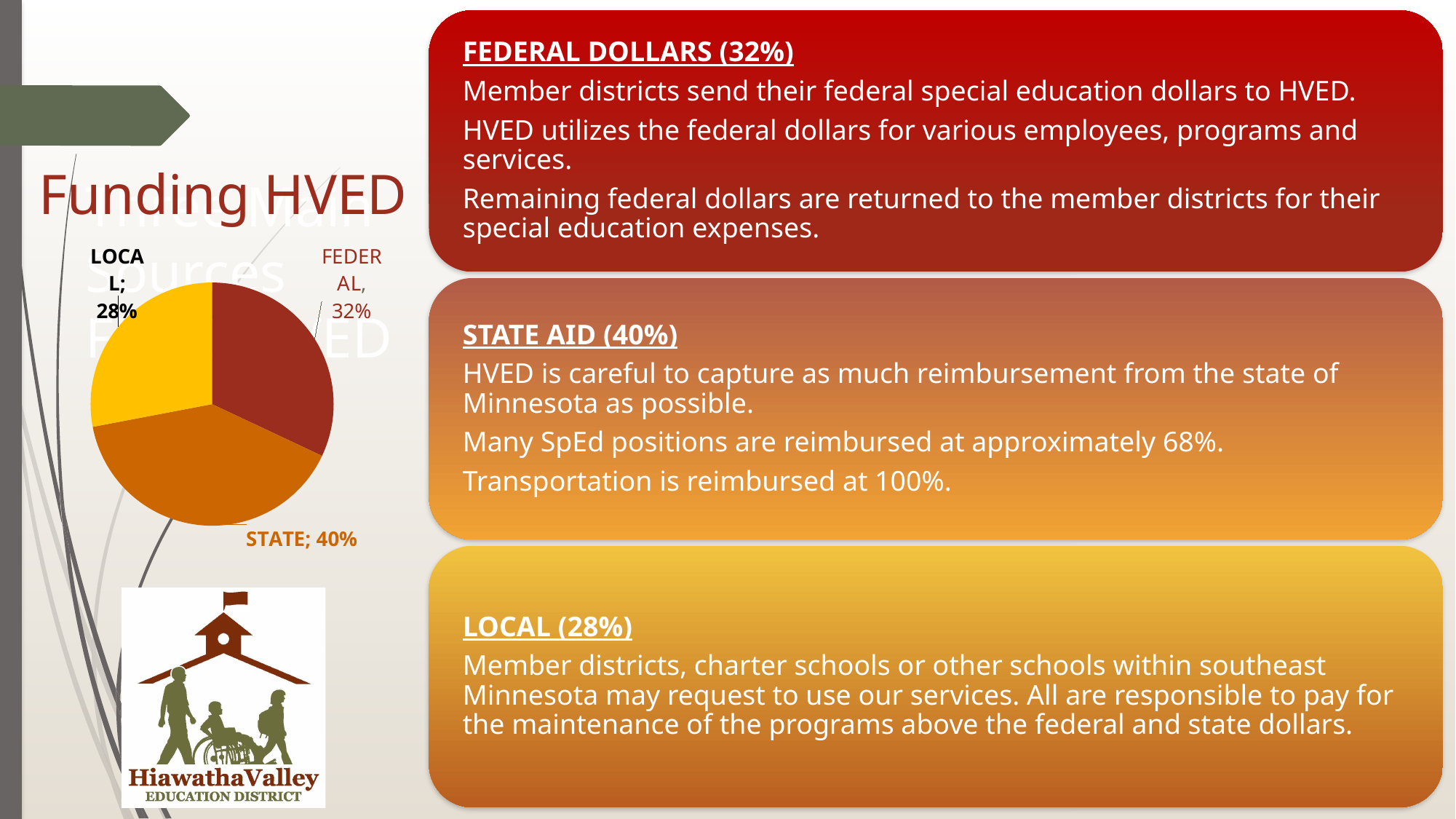
What share of the pie does LOCAL represent? 28% Which slice of the pie chart is the smallest? LOCAL What is the difference in percentage points between the STATE and LOCAL slices? 12 What colour is the STATE slice of the pie chart? orange What is the difference in percentage points between the FEDERAL and LOCAL slices? 4 What kind of chart is shown on the slide? pie chart How many slices does the pie chart have? 3 What share of the pie does FEDERAL represent? 32% What share of the pie does STATE represent? 40% Which is larger, the FEDERAL slice or the STATE slice? STATE Which slice of the pie chart is the largest? STATE What colour is the LOCAL slice of the pie chart? yellow